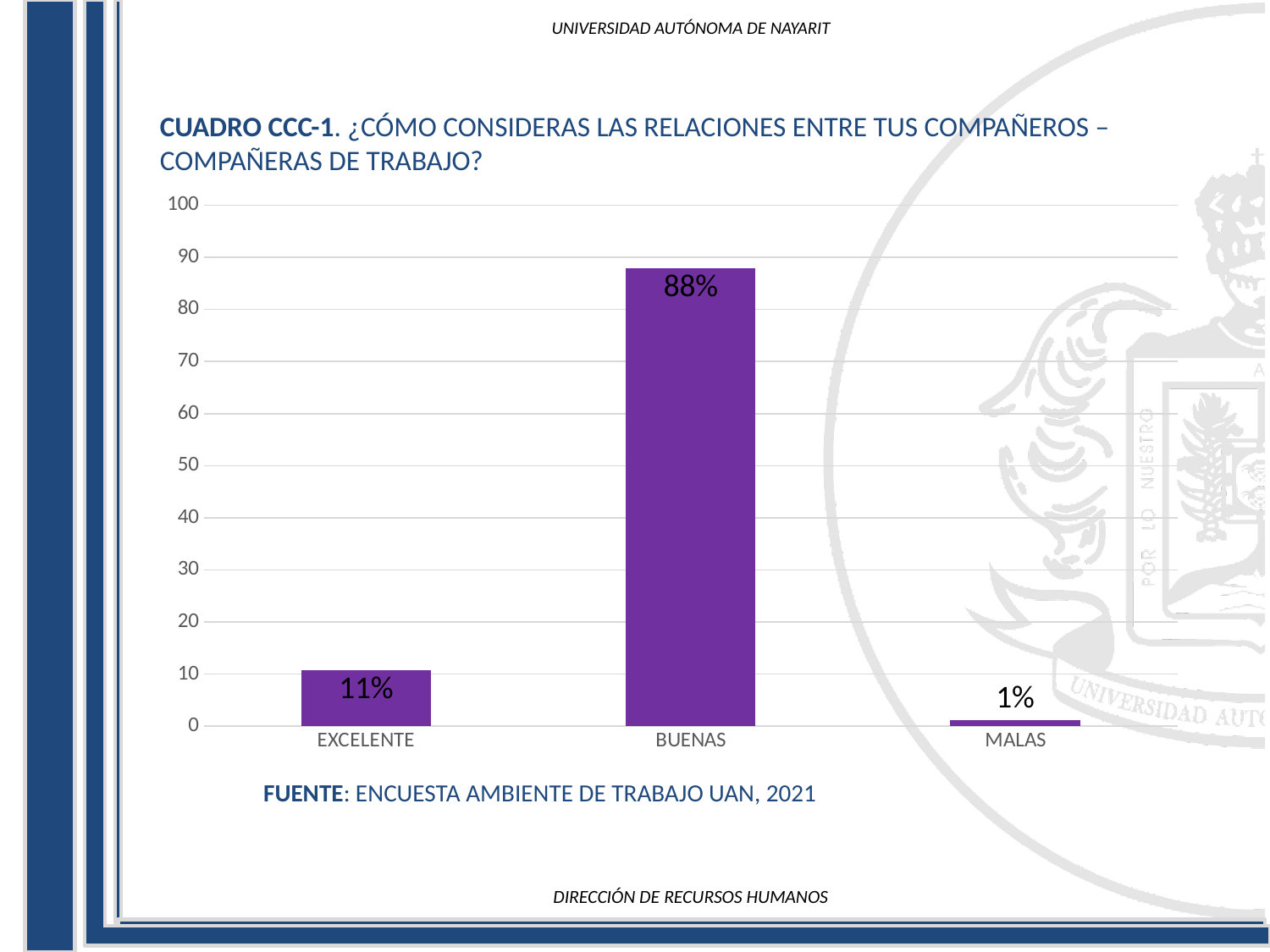
What is the value for EXCELENTE? 11% What is the value for MALAS? 1% Which is larger, the value for EXCELENTE or the value for MALAS? EXCELENTE What is the difference between the values for BUENAS and EXCELENTE? 77% Which category has the lowest value? MALAS Is the value for BUENAS greater or less than 80? greater Which category has the highest value? BUENAS What is the value for BUENAS? 88% What source is cited below the chart? ENCUESTA AMBIENTE DE TRABAJO UAN, 2021 What is the difference between the values for EXCELENTE and MALAS? 10% How many categories are shown on the x axis? 3 What kind of chart is shown on the slide? bar chart